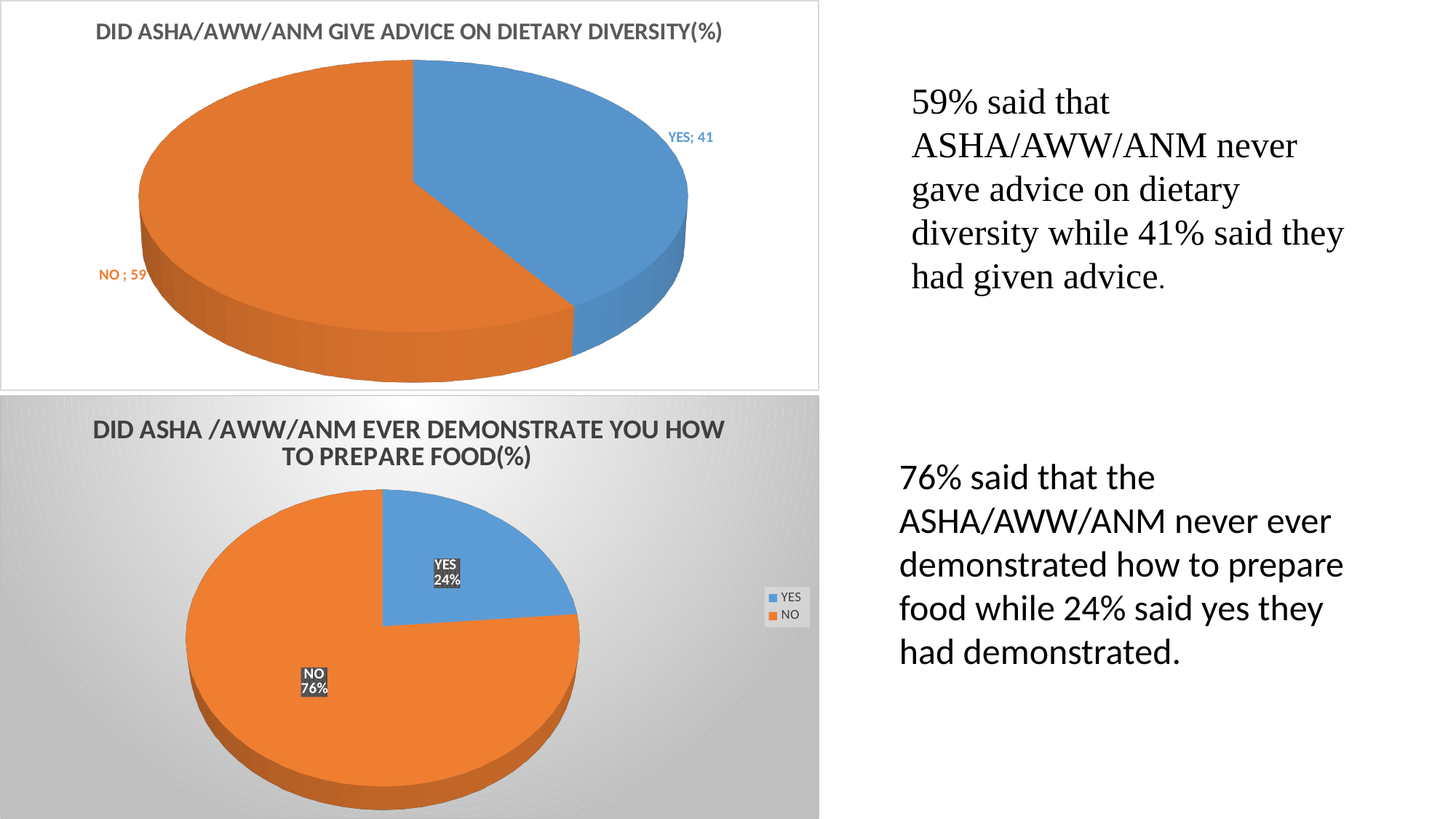
In the bottom chart (DID ASHA/AWW/ANM EVER DEMONSTRATE YOU HOW TO PREPARE FOOD), which colour represents NO? Orange In the bottom chart (DID ASHA/AWW/ANM EVER DEMONSTRATE YOU HOW TO PREPARE FOOD), which category has the smaller slice? YES In the bottom chart (DID ASHA/AWW/ANM EVER DEMONSTRATE YOU HOW TO PREPARE FOOD), what is the difference between the NO and YES shares? 52% In the bottom chart (DID ASHA/AWW/ANM EVER DEMONSTRATE YOU HOW TO PREPARE FOOD), what is the value for YES? 24% In the bottom chart (DID ASHA/AWW/ANM EVER DEMONSTRATE YOU HOW TO PREPARE FOOD), what is the value for NO? 76% How many categories does the bottom chart's legend list? 2 Is the YES value in the top chart larger or smaller than the YES value in the bottom chart? Larger In the top chart (DID ASHA/AWW/ANM GIVE ADVICE ON DIETARY DIVERSITY), what is the value for YES? 41 In the top chart (DID ASHA/AWW/ANM GIVE ADVICE ON DIETARY DIVERSITY), what is the value for NO? 59 In the top chart (DID ASHA/AWW/ANM GIVE ADVICE ON DIETARY DIVERSITY), which category has the larger slice? NO What kind of chart is the top chart on the slide? Pie chart In the top chart (DID ASHA/AWW/ANM GIVE ADVICE ON DIETARY DIVERSITY), what is the difference between the NO and YES values? 18